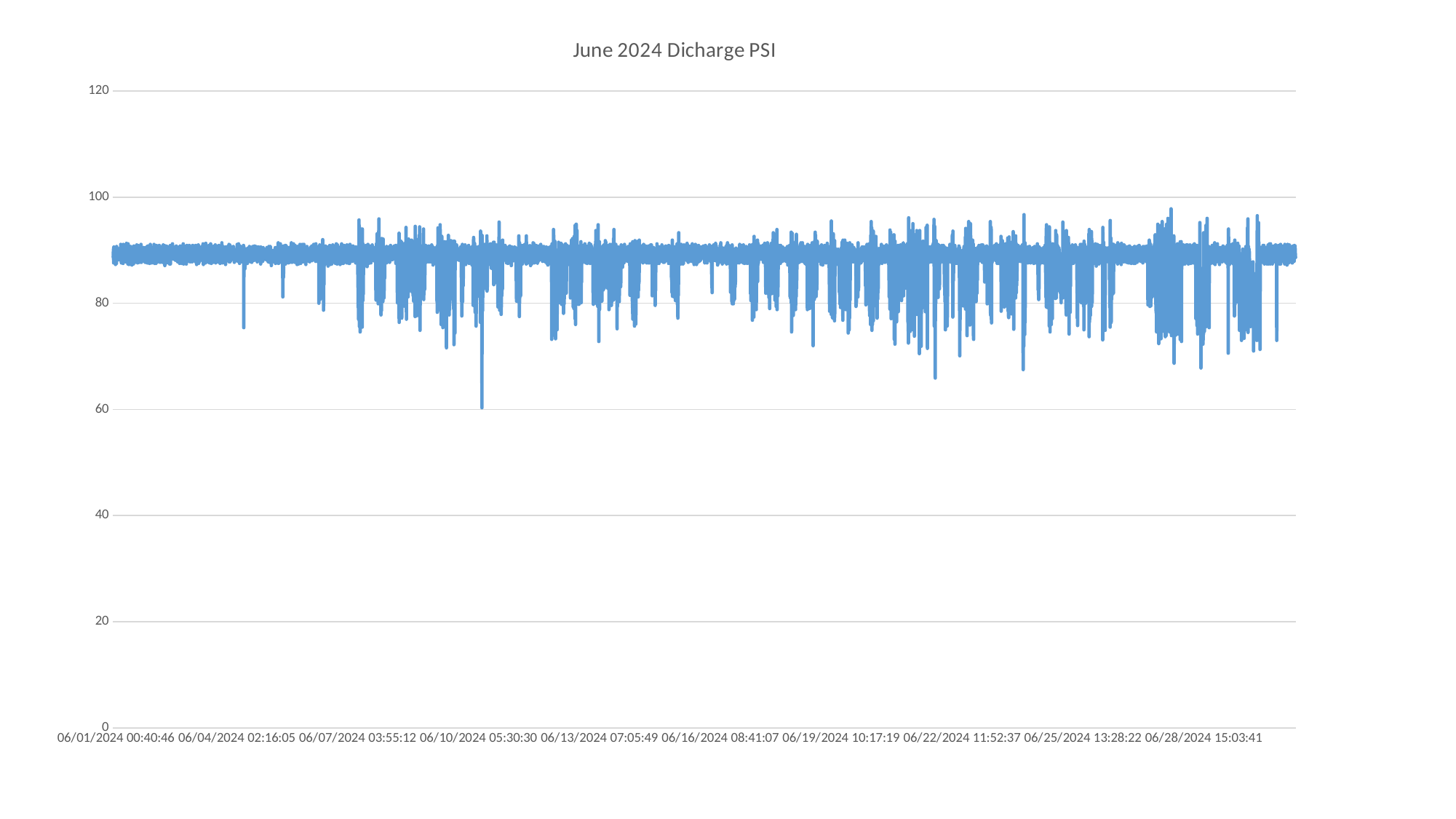
How many lines are plotted on the chart? 1 Is the deepest dip in the line greater or less than 40? greater Does the line ever rise above 100 during the month? no Is the highest point reached by the line greater or less than 100? less How many date labels are shown along the horizontal axis? 10 What kind of chart is shown on the slide? line chart What is the title of the chart? June 2024 Dicharge PSI What is the highest value labelled on the vertical axis? 120